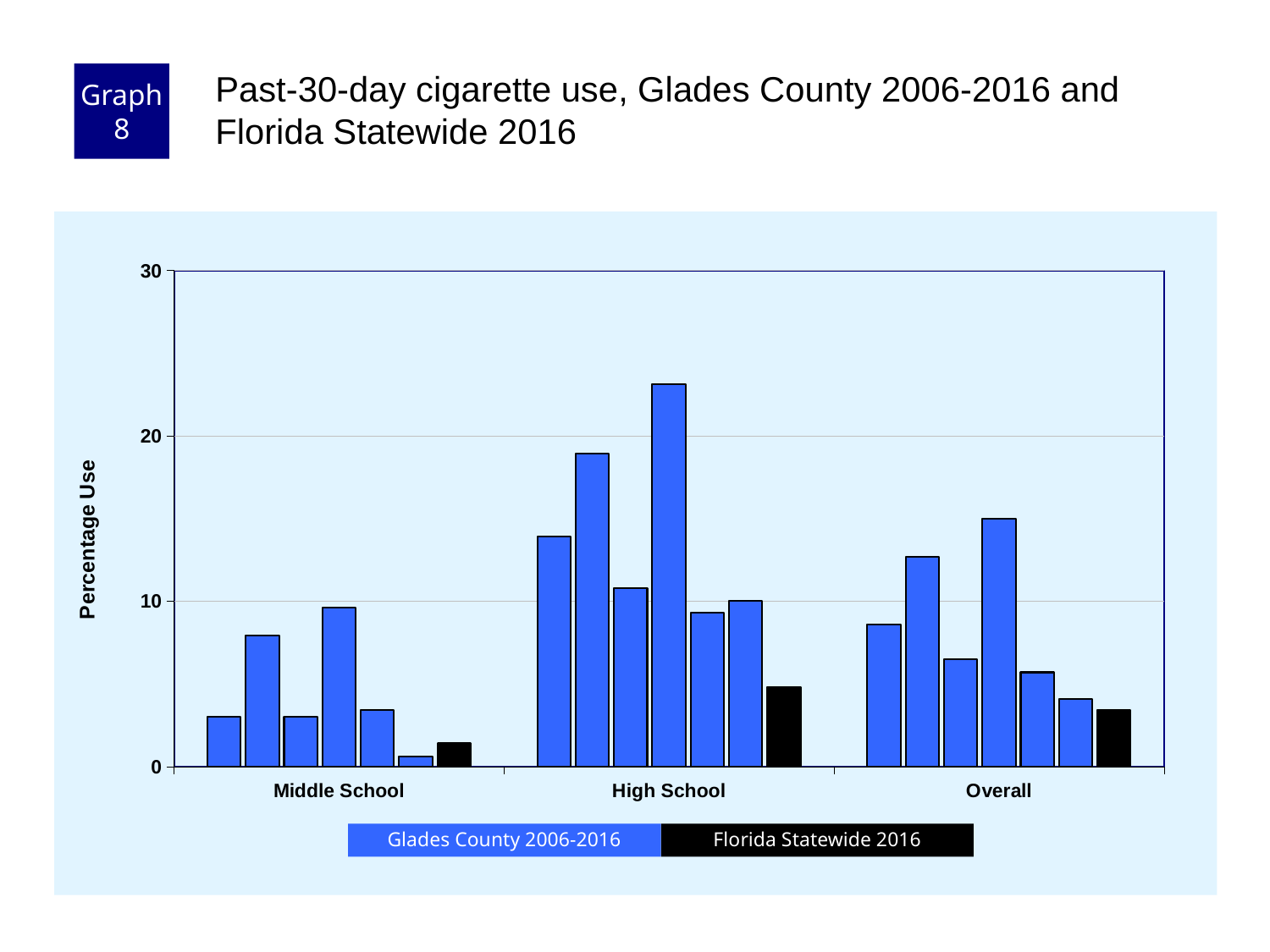
Is the tallest Glades County 2006-2016 bar for Overall greater or less than 20? less What kind of chart is shown on the slide? bar chart Which category group contains the tallest bar in the chart? High School Is the Florida Statewide 2016 value for Middle School greater or less than 10? less What is the label on the y axis? Percentage Use How many Glades County 2006-2016 bars are shown in each category group? 6 How many series does the legend list? 2 What colour are the Florida Statewide 2016 bars? black Is the tallest Glades County 2006-2016 bar for High School greater or less than 20? greater Which is larger, the Florida Statewide 2016 value for High School or for Middle School? High School How many category groups are shown on the x axis? 3